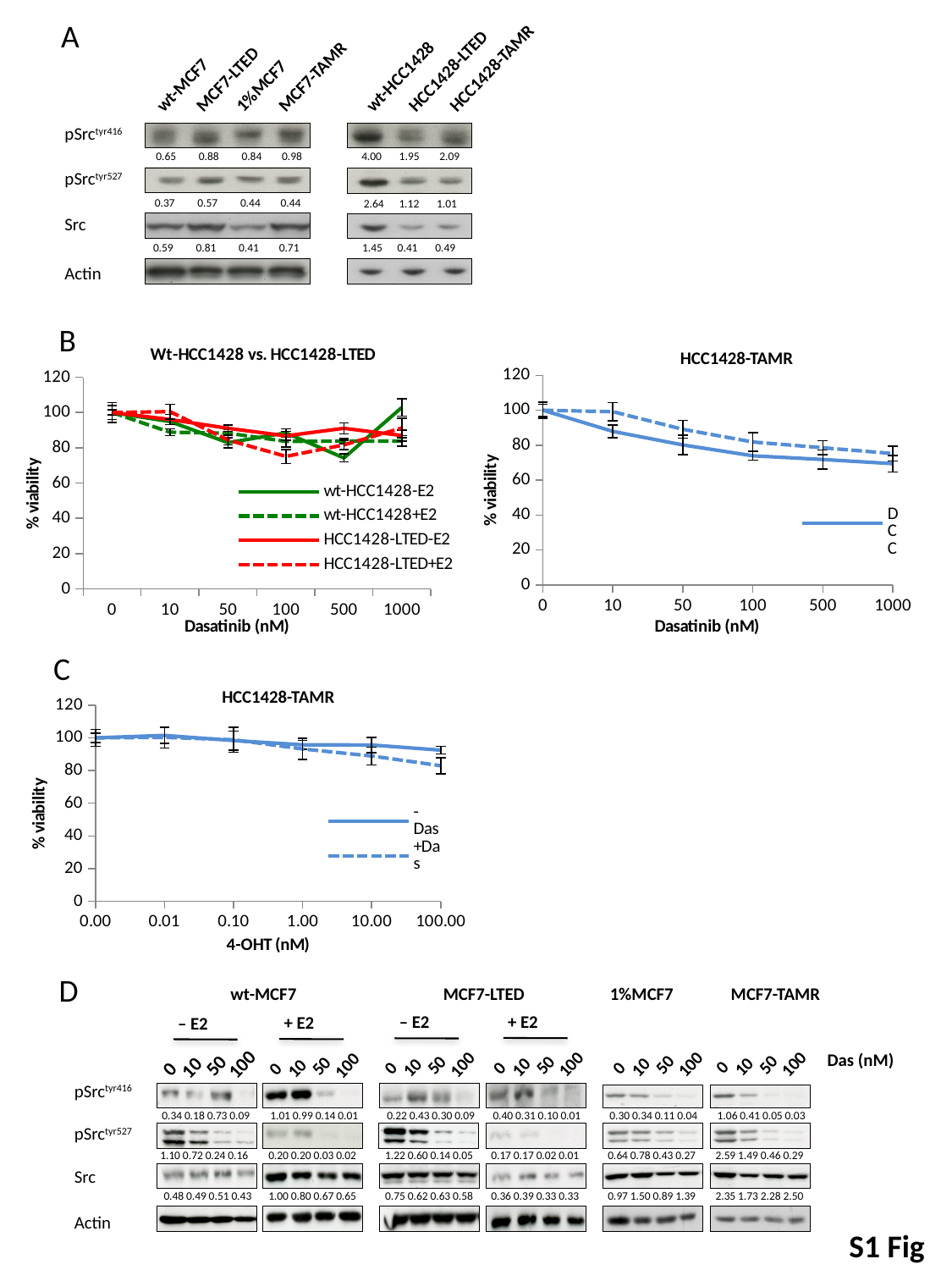
In the 'Wt-HCC1428 vs. HCC1428-LTED' chart, which colour is used for the HCC1428-LTED series? red In the 'HCC1428-TAMR' chart in panel C, is the % viability of the -Das series at 100.00 nM 4-OHT greater or less than 80? greater How many series does the legend of the 'HCC1428-TAMR' chart in panel C list? 2 In the 'HCC1428-TAMR' chart in panel B, is the % viability at 0 nM Dasatinib greater or less than 80? greater In the 'Wt-HCC1428 vs. HCC1428-LTED' chart, what is the label of the y axis? % viability What kind of chart is the 'Wt-HCC1428 vs. HCC1428-LTED' chart in panel B? line chart In the 'HCC1428-TAMR' chart in panel C, which series has the higher % viability at 100.00 nM 4-OHT, -Das or +Das? -Das How many Dasatinib concentrations are marked on the x axis of the 'Wt-HCC1428 vs. HCC1428-LTED' chart? 6 What is the x-axis label of the 'HCC1428-TAMR' chart in panel C? 4-OHT (nM) How many series does the legend of the 'Wt-HCC1428 vs. HCC1428-LTED' chart list? 4 In the 'HCC1428-TAMR' chart in panel B, is the % viability at 1000 nM Dasatinib greater or less than 80? less In the 'HCC1428-TAMR' chart in panel B, does % viability rise or fall as the Dasatinib concentration increases? fall